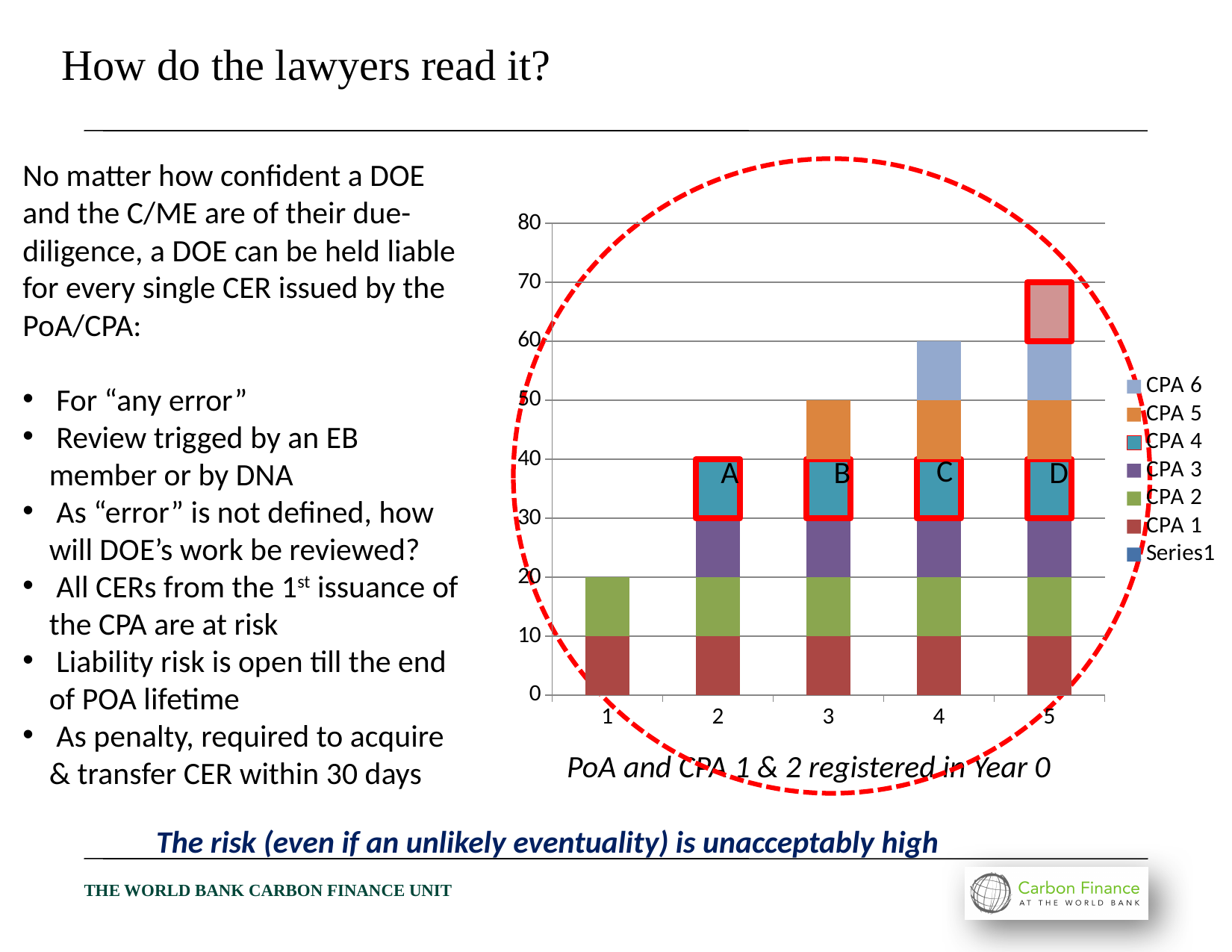
Do the stacked bar totals rise or fall from category 1 to category 5? rise Is the total for the category 5 bar greater or less than 60? greater What is the total height of the stacked bar for category 4? 60 Which category has the highest stacked bar? 5 What is the last entry listed in the chart's legend? Series1 Which category has the lowest stacked bar? 1 How many categories are shown along the x axis of the chart? 5 Which stacked bar is taller, category 2 or category 3? 3 What is the total height of the stacked bar for category 1? 20 What kind of chart is shown on the slide? stacked bar chart How many series does the chart's legend list? 7 What is the difference between the stacked bar totals for category 4 and category 1? 40